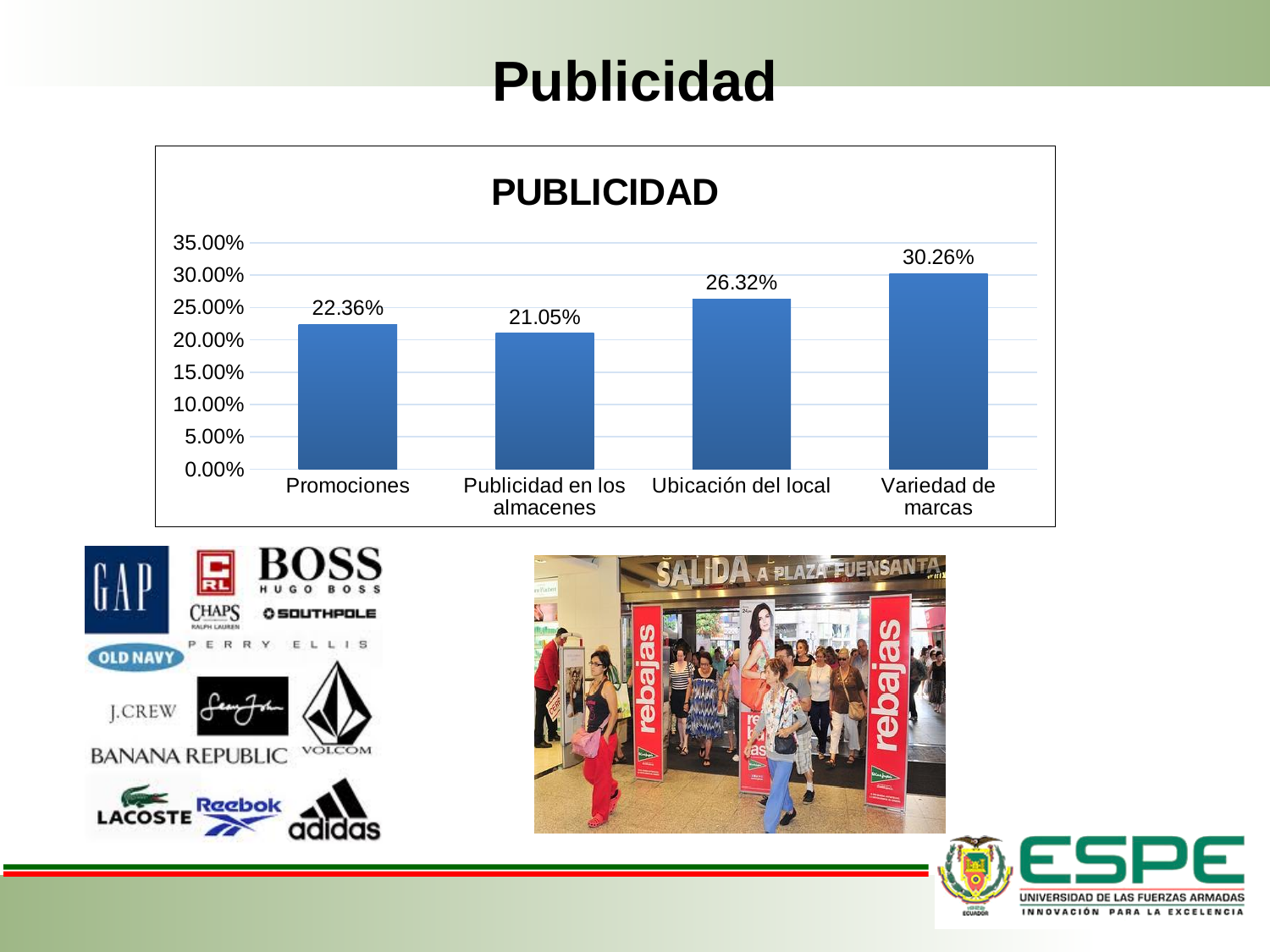
What is the difference between the values for Variedad de marcas and Ubicación del local? 3.94% Which category has the highest value? Variedad de marcas What is the value for Promociones? 22.36% Is the value for Variedad de marcas greater or less than 25.00%? greater What is the title of the chart? PUBLICIDAD What kind of chart is shown? bar chart What is the value for Variedad de marcas? 30.26% What is the value for Publicidad en los almacenes? 21.05% Which category has the lowest value? Publicidad en los almacenes Which is larger, the value for Promociones or the value for Ubicación del local? Ubicación del local What is the value for Ubicación del local? 26.32% How many categories are shown in the chart? 4